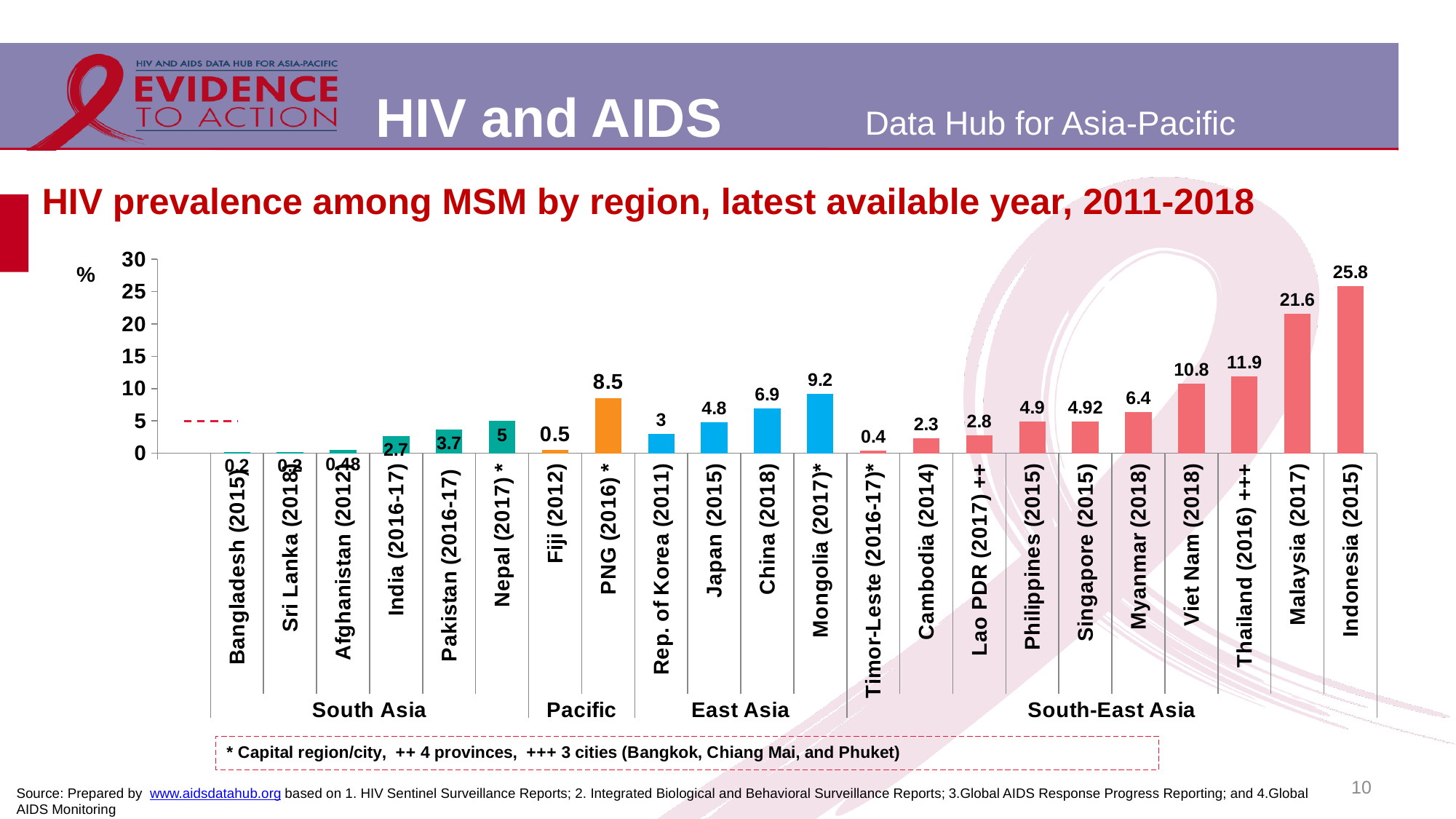
Is the value for Malaysia (2017) greater or less than 20? greater How many countries are plotted in the chart? 22 How many regional groups are labelled along the bottom of the chart? 4 Which has the larger value, Thailand (2016) +++ or Viet Nam (2018)? Thailand (2016) +++ Within the East Asia group, which country has the lowest value? Rep. of Korea (2011) What value is shown for PNG (2016)*? 8.5 What is the HIV prevalence value shown for Indonesia (2015)? 25.8 What is the difference between the values for China (2018) and Japan (2015)? 2.1 What value is shown for Mongolia (2017)*? 9.2 Which country has the highest HIV prevalence among MSM in the chart? Indonesia (2015) What is the difference between the values for Indonesia (2015) and Malaysia (2017)? 4.2 What kind of chart is shown on the slide? Bar chart